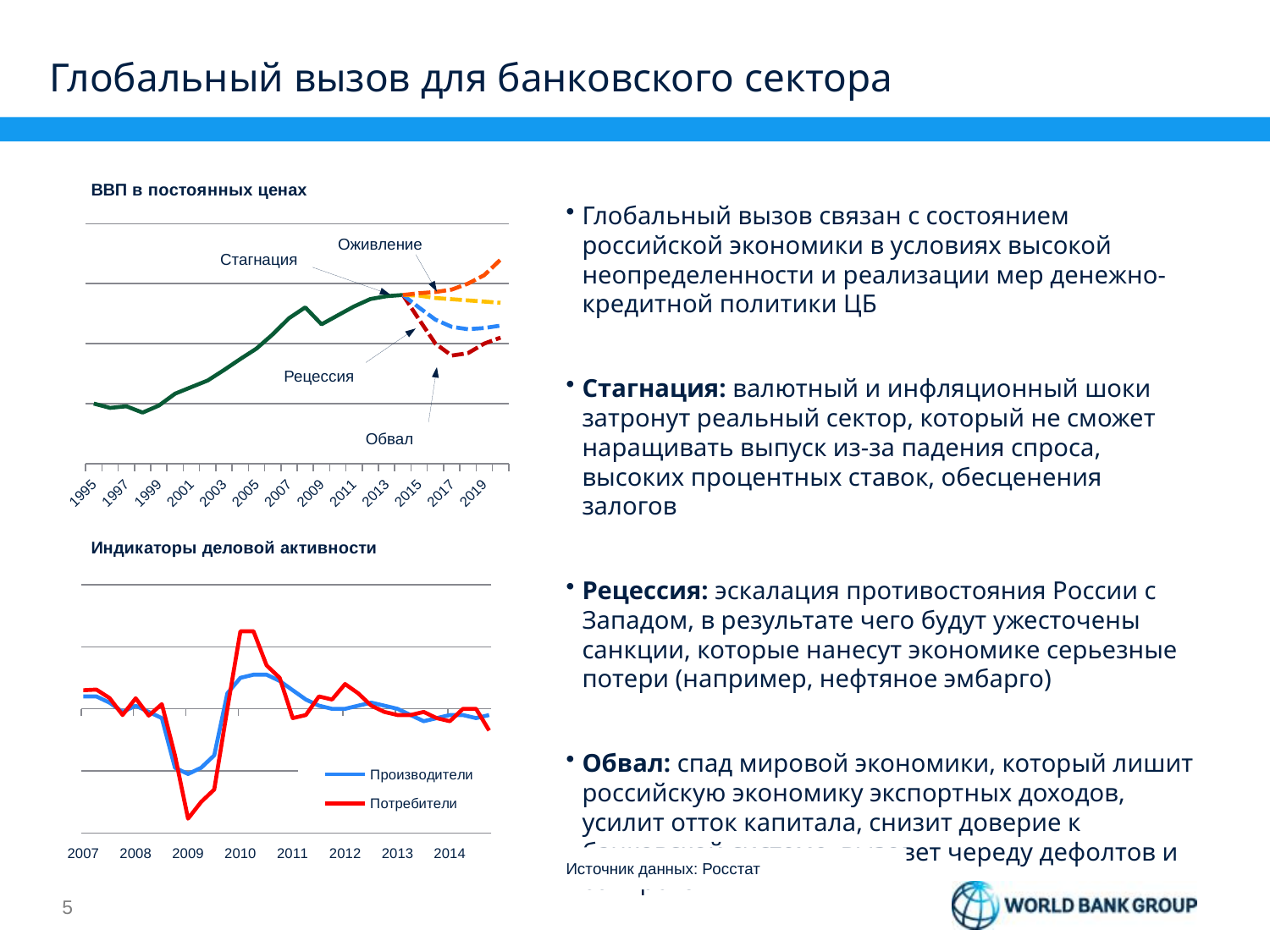
In the chart "Индикаторы деловой активности", which series reaches the higher value at the 2010 peak, Производители or Потребители? Потребители In the chart "Индикаторы деловой активности", which series reaches the lower value at the 2009 trough, Производители or Потребители? Потребители What is the first year shown on the x axis of the chart "ВВП в постоянных ценах"? 1995 In the chart "ВВП в постоянных ценах", which scenario is higher in 2019, Стагнация or Рецессия? Стагнация In the chart "ВВП в постоянных ценах", which scenario ends highest in 2019? Оживление What are the two series named in the legend of the chart "Индикаторы деловой активности"? Производители and Потребители In the chart "ВВП в постоянных ценах", how many labelled scenario paths branch off after 2014? 4 What kind of chart is the chart titled "Индикаторы деловой активности"? Line chart What kind of chart is the chart titled "ВВП в постоянных ценах"? Line chart In the chart "ВВП в постоянных ценах", does the GDP line generally rise or fall from 1999 to 2008? Rise In the chart "ВВП в постоянных ценах", which scenario ends lowest in 2019? Обвал How many series does the legend of the chart "Индикаторы деловой активности" list? 2